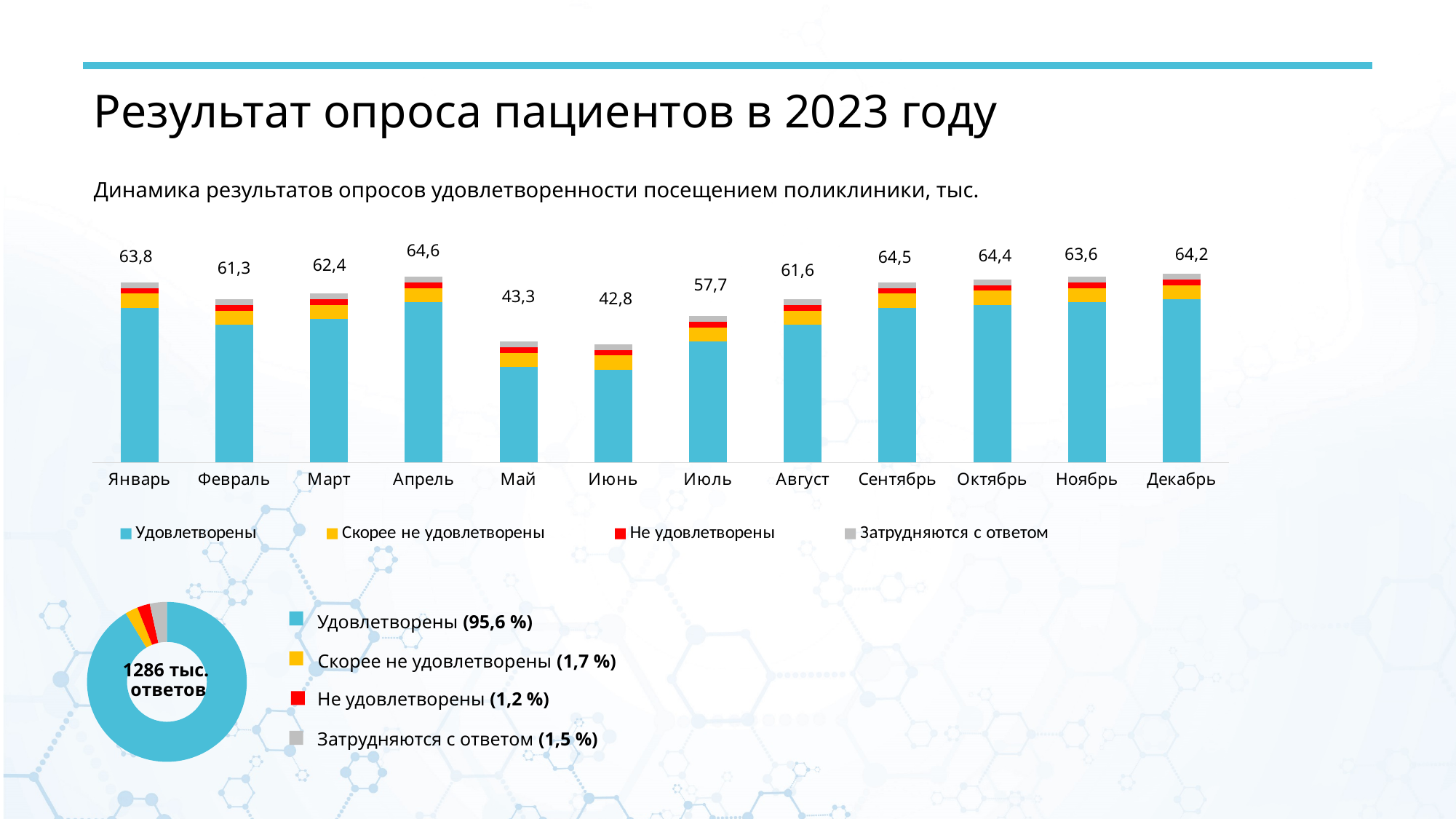
In the donut chart, what share is shown for Удовлетворены? 95,6 % In the bar chart, what is the total value labelled for Апрель? 64,6 In the bar chart, which month has the highest labelled total? Апрель What kind of chart is the upper chart on the slide? Stacked bar chart In the bar chart, what is the total value labelled for Июль? 57,7 In the bar chart, what is the difference between the labelled totals for Апрель and Июнь? 21,8 In the bar chart, which is larger, the total for Июль or the total for Август? Август What text is shown in the centre of the donut chart? 1286 тыс. ответов In the bar chart, which month has the lowest labelled total? Июнь In the bar chart, do the labelled totals rise or fall from Апрель to Июнь? Fall How many months are shown on the x axis of the bar chart? 12 How many series does the legend of the bar chart list? 4